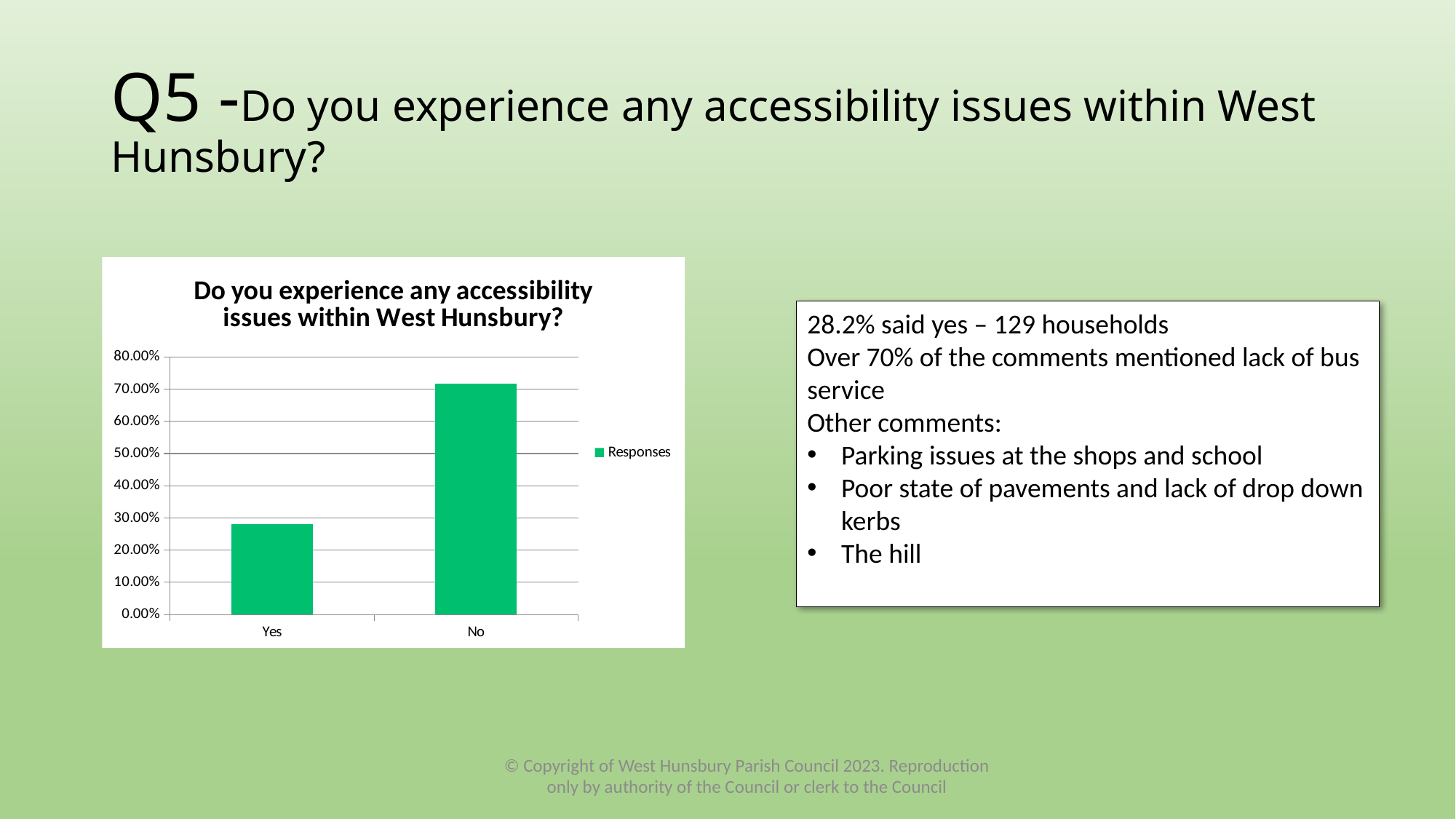
Which category has the highest value in the chart? No How many series does the chart legend list? 1 Which is larger in the chart, the value for Yes or the value for No? No Do the values rise or fall moving from Yes to No along the x axis? rise What kind of chart is shown on the slide? bar chart What is the title of the chart? Do you experience any accessibility issues within West Hunsbury? Is the value for Yes greater or less than 20.00%? greater How many categories are shown on the x axis of the chart? 2 Is the value for Yes greater or less than 30.00%? less Which category has the lowest value in the chart? Yes What is the name of the series listed in the chart legend? Responses Is the value for No greater or less than 60.00%? greater